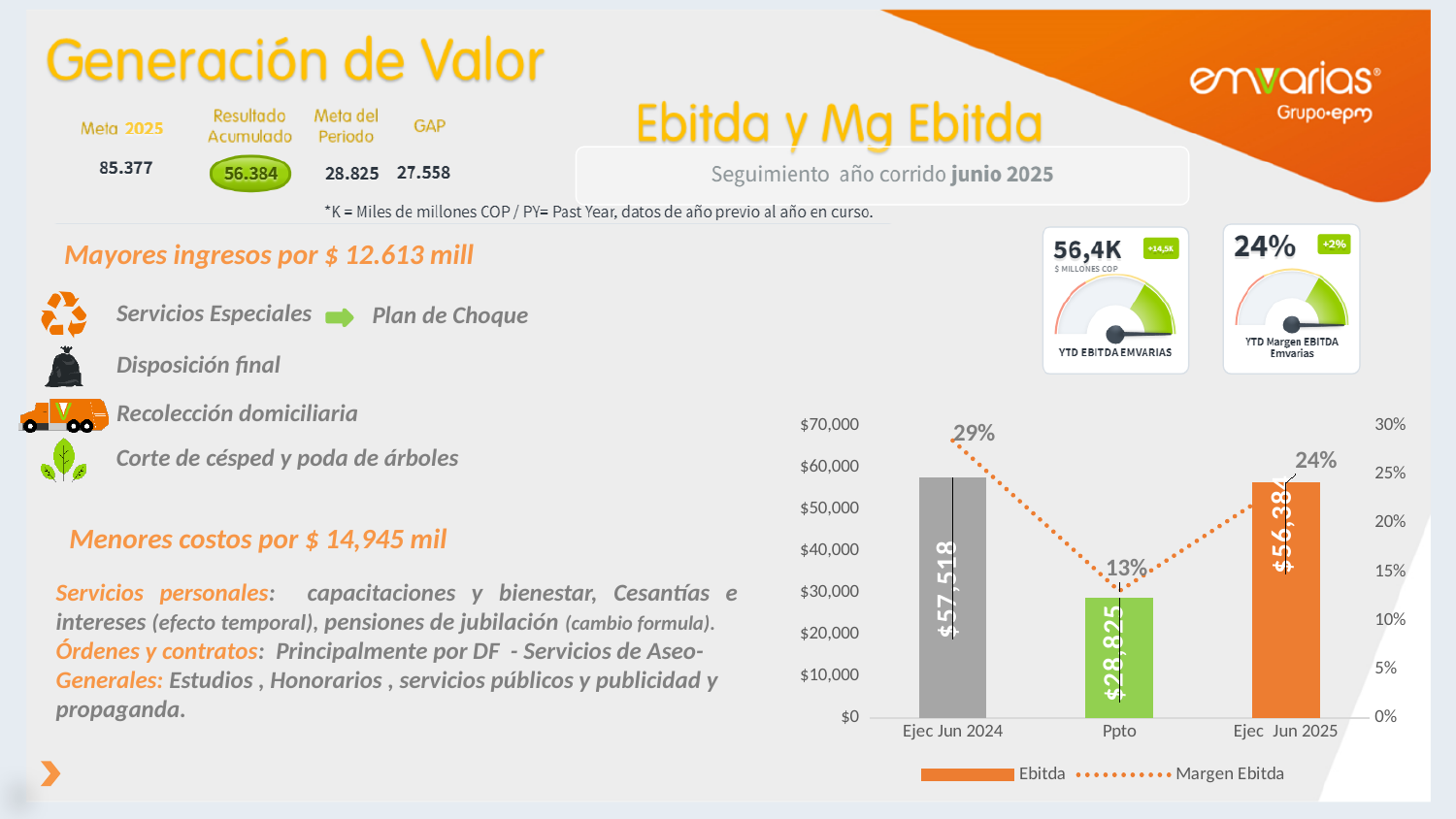
What are the two entries in the legend of the bar chart? Ebitda and Margen Ebitda In the bar chart, which category has the lowest Margen Ebitda? Ppto How many categories are shown on the x axis of the bar chart? 3 In the bar chart, what is the Margen Ebitda for Ejec Jun 2025? 24% In the bar chart, what is the difference in Margen Ebitda between Ejec Jun 2024 and Ppto? 16 percentage points How many series does the legend of the bar chart list? 2 In the bar chart, what is the Ebitda value for Ppto? $28,825 In the bar chart, which has a larger Ebitda, Ejec Jun 2024 or Ejec Jun 2025? Ejec Jun 2024 In the bar chart, which category has the highest Ebitda? Ejec Jun 2024 In the bar chart, is the Ebitda value for Ppto greater or less than $30,000? less In the bar chart, what is the difference in Ebitda between Ejec Jun 2024 and Ppto? $28,693 In the bar chart, what is the Ebitda value for Ejec Jun 2024? $57,518